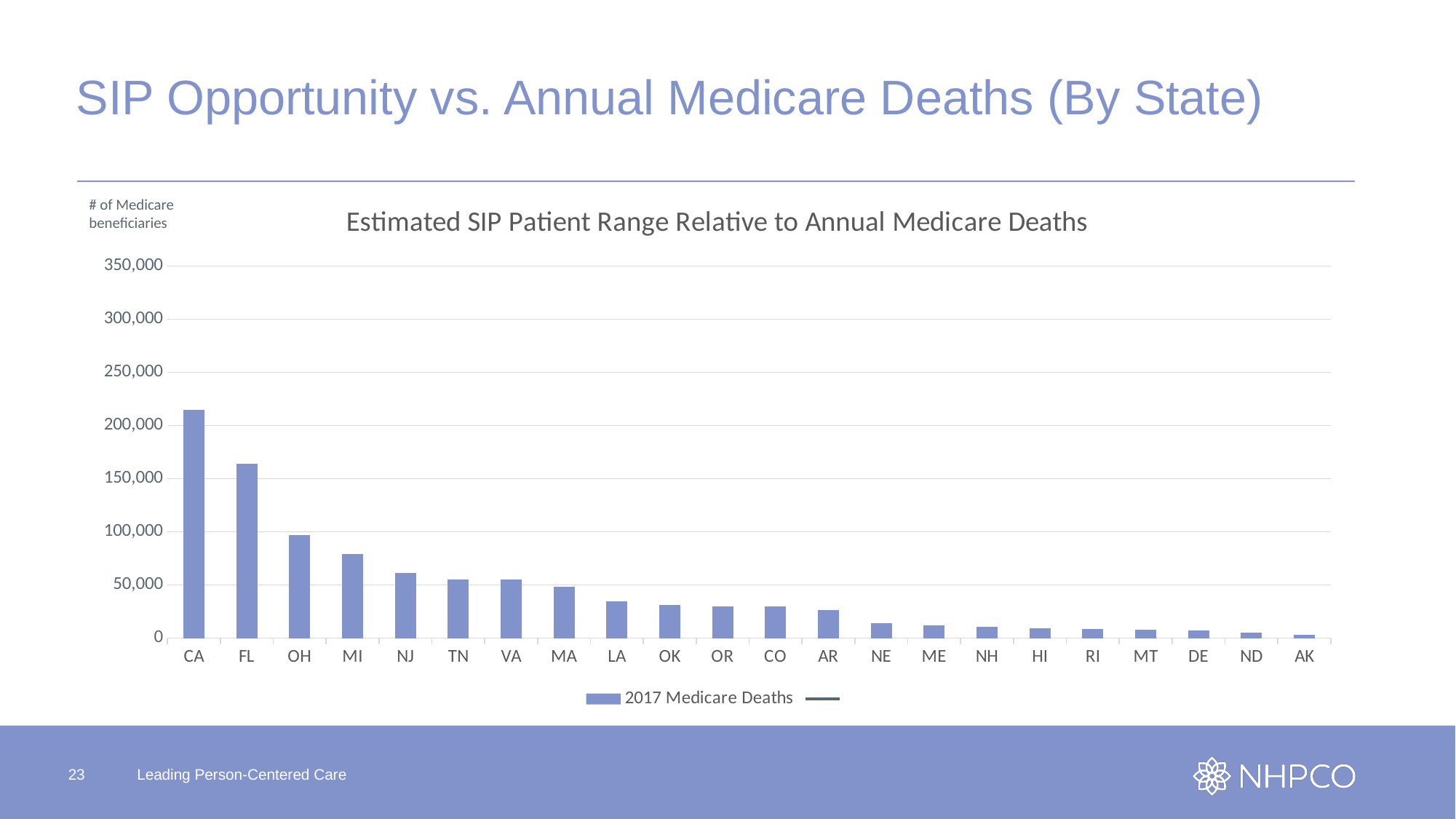
Which state has the highest number of 2017 Medicare deaths? CA Do the bar values rise or fall moving from left to right along the x axis? fall Is the value for CA greater or less than 200,000? greater What is the name of the bar series shown in the legend? 2017 Medicare Deaths How many states are shown on the x axis of the chart? 22 Is the value for FL greater or less than 200,000? less Is the value for LA greater or less than 50,000? less What kind of chart is shown on the slide? bar chart What is the title of the chart? Estimated SIP Patient Range Relative to Annual Medicare Deaths Which has a larger value, FL or OH? FL Which state has the lowest number of 2017 Medicare deaths? AK